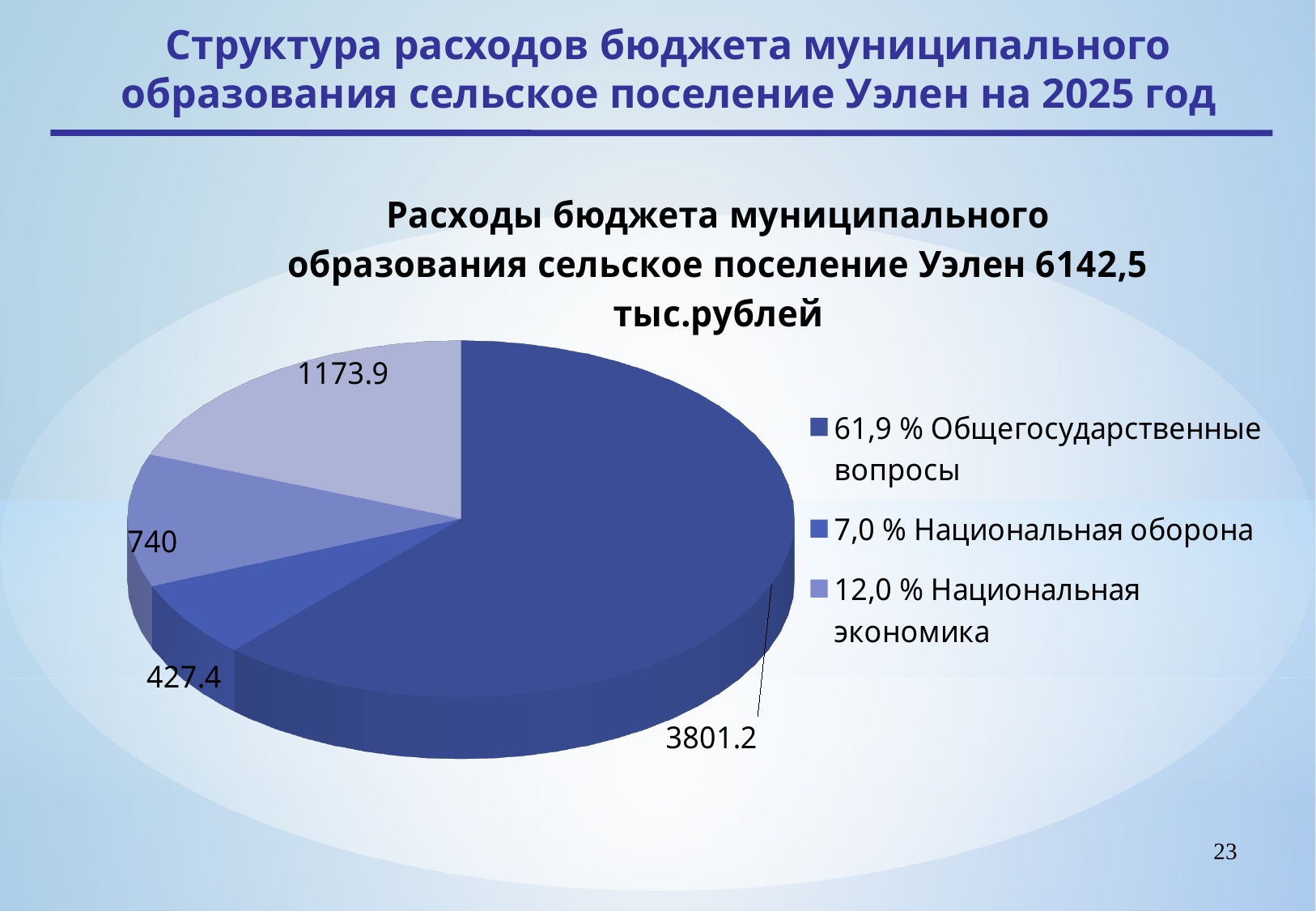
How many entries does the legend of the pie chart list? 3 What is the difference between the Национальная экономика value and the Национальная оборона value? 312.6 What is the difference between the Общегосударственные вопросы value and the Национальная оборона value? 3373.8 Which is larger: the Национальная экономика slice or the Национальная оборона slice? Национальная экономика How many slices does the pie chart have? 4 Which category has the smallest slice in the pie chart? Национальная оборона What kind of chart is shown on the slide? pie chart Which category has the largest slice in the pie chart? Общегосударственные вопросы What value is shown for the Общегосударственные вопросы slice of the pie chart? 3801.2 What value is shown for the Национальная оборона slice of the pie chart? 427.4 What share of the pie does Общегосударственные вопросы represent, according to the legend? 61,9 % What value is shown for the Национальная экономика slice of the pie chart? 740